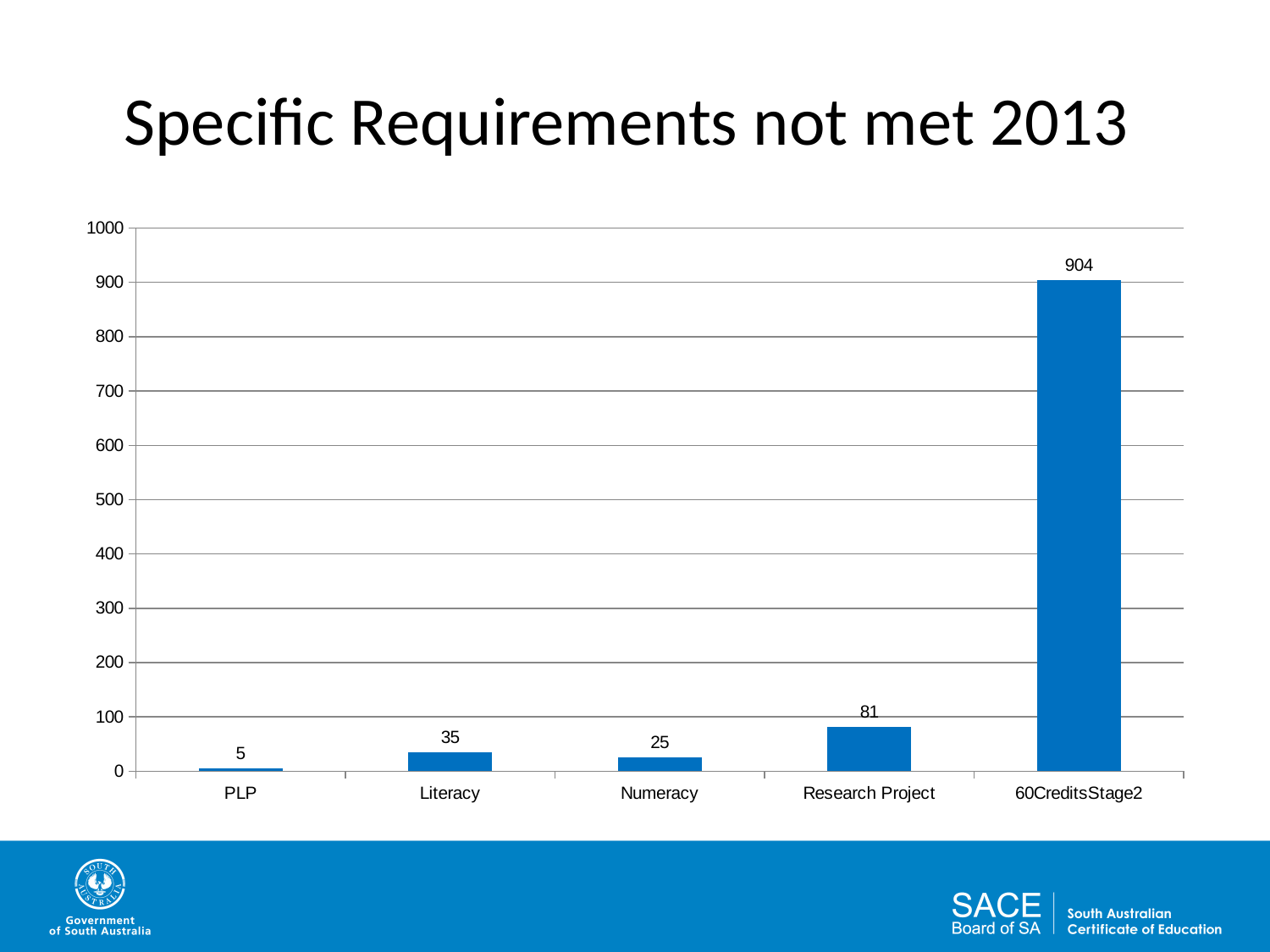
Which category has the lowest value? PLP Which category has the highest value? 60CreditsStage2 What is the difference between the values for Literacy and Numeracy? 10 What kind of chart is shown on the slide? bar chart What is the value for Research Project? 81 What is the title of the slide? Specific Requirements not met 2013 What is the difference between the values for 60CreditsStage2 and Research Project? 823 How many categories are shown on the x axis? 5 What is the value for PLP? 5 What is the value for Literacy? 35 Is the value for 60CreditsStage2 greater or less than 800? greater Which is larger, the value for Literacy or the value for Numeracy? Literacy